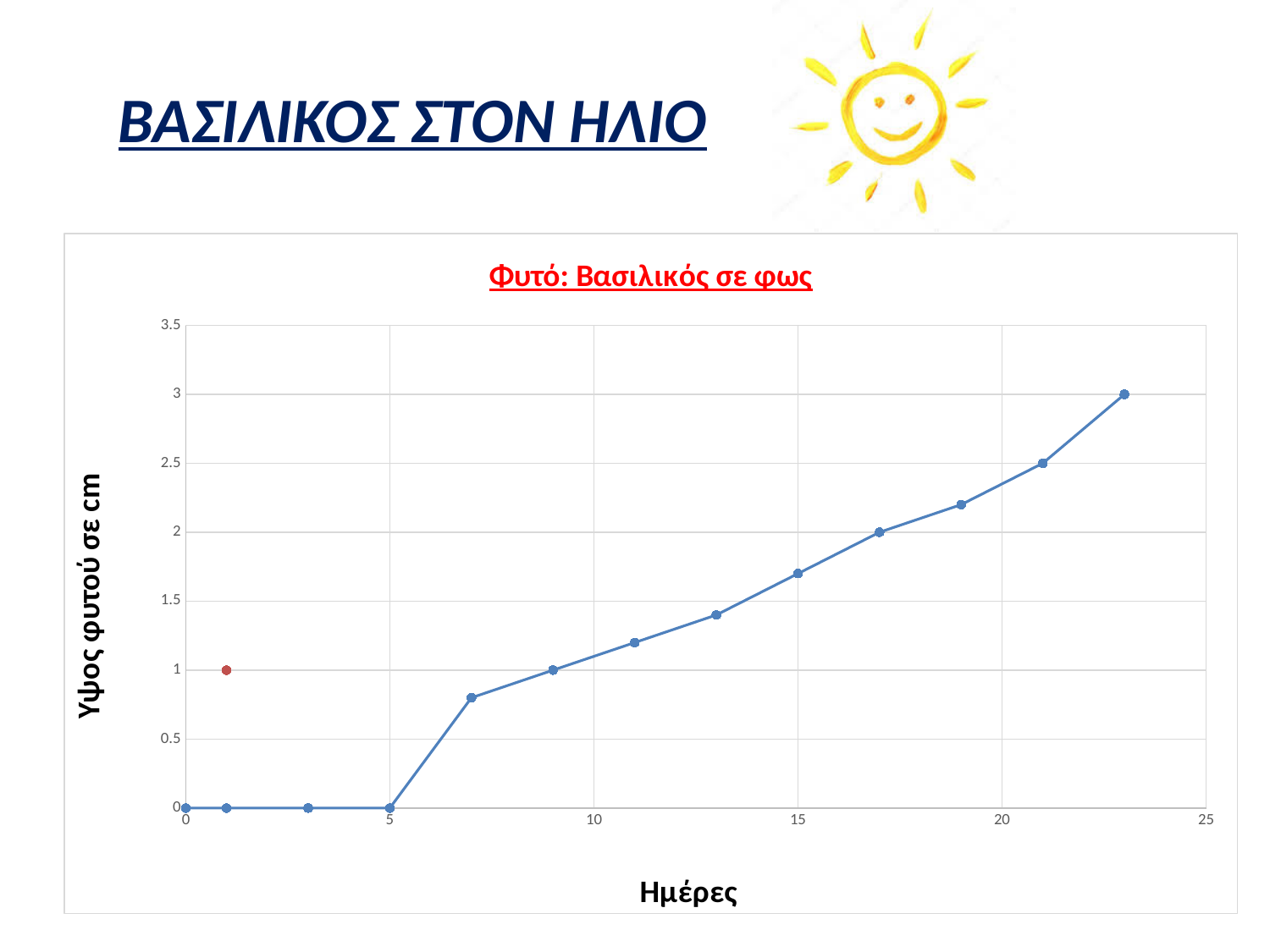
Is the plant height on day 7 greater or less than 1? less On which day is the plant height highest? 23 What is the plant height on day 5? 0 What is the plant height on day 9? 1 What is the label of the vertical axis? Ύψος φυτού σε cm What is the plant height on day 21? 2.5 What kind of chart is shown on the slide? line chart What is the plant height on day 17? 2 Is the plant height on day 15 greater or less than 1.5? greater What is the title of the chart? Φυτό: Βασιλικός σε φως What is the plant height on day 23? 3 Does the plant height rise or fall as the days increase? rise